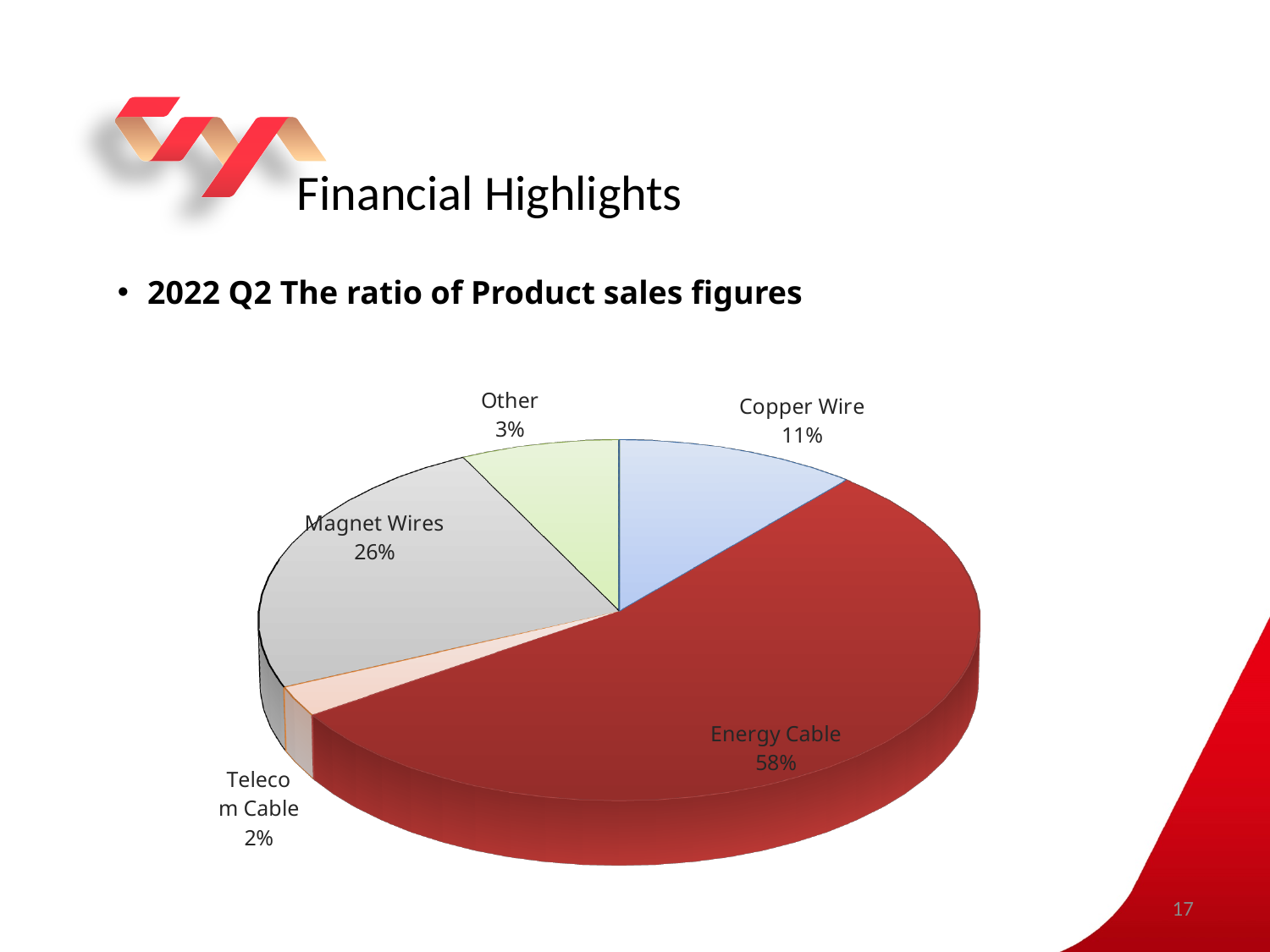
What percentage does Telecom Cable represent? 2% What colour is the Energy Cable slice? Red What is the share labelled for Other? 3% Which product category has the largest share of sales? Energy Cable What share of product sales does Energy Cable account for? 58% How many product categories are shown in the pie chart? 5 What percentage of product sales is Magnet Wires? 26% What type of chart is shown on the slide? Pie chart Which has a larger share, Copper Wire or Magnet Wires? Magnet Wires Which product category has the smallest share of sales? Telecom Cable What is the share for Copper Wire? 11% What is the difference in percentage points between Energy Cable and Magnet Wires? 32